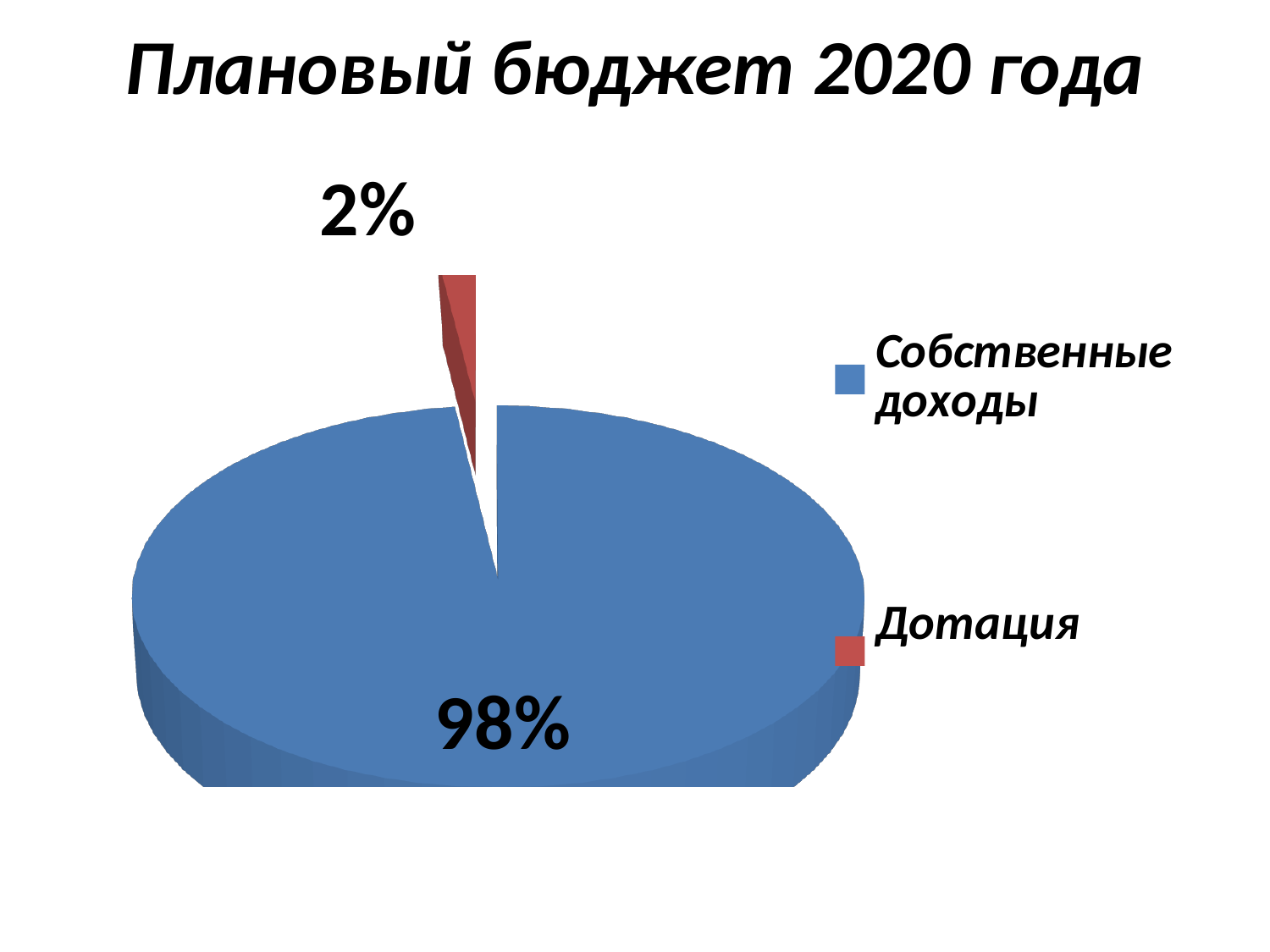
What share of the pie does Дотация take? 2% Which slice is the largest? Собственные доходы What colour is the Дотация slice? red Which slice is the smallest? Дотация What is the difference in percentage points between Собственные доходы and Дотация? 96 What share of the pie does Собственные доходы take? 98% What is the title of the slide? Плановый бюджет 2020 года How many entries does the legend list? 2 What kind of chart is shown on the slide? pie chart How many slices does the pie chart have? 2 Which is larger, Собственные доходы or Дотация? Собственные доходы